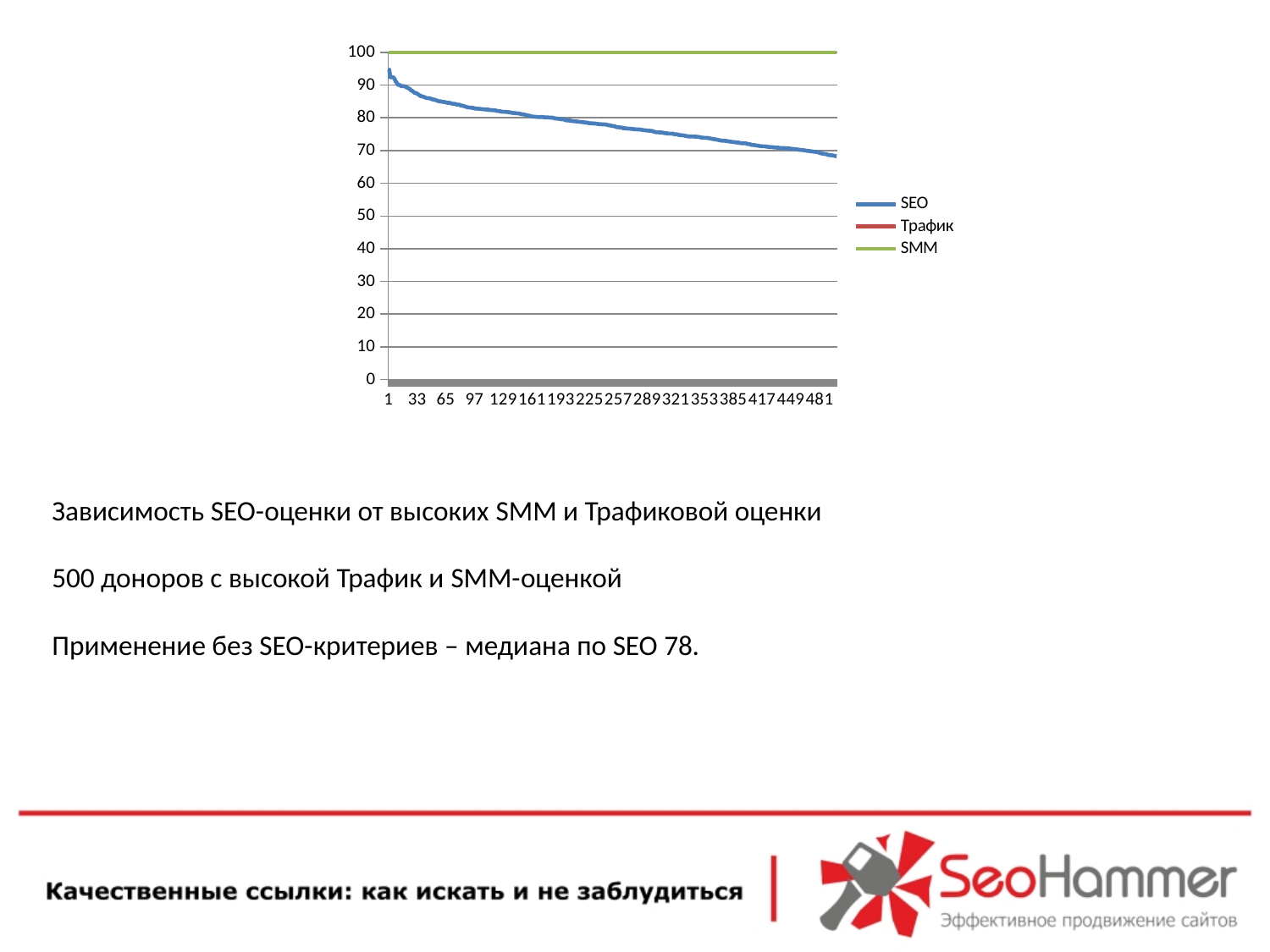
What is the highest value shown on the y axis? 100 How many series does the legend list? 3 What value does the SMM line stay at across the chart? 100 Is the SEO value at x = 481 greater or less than 80? less Which is larger at x = 193, the SMM value or the SEO value? SMM Which series are listed in the legend? SEO, Трафик, SMM Does the SMM line rise, fall or stay flat along the x axis? stay flat Is the SEO value at x = 1 greater or less than 90? greater What kind of chart is shown on the slide? line chart Is the SEO value at x = 257 greater or less than 70? greater Does the SEO line rise or fall along the x axis? fall